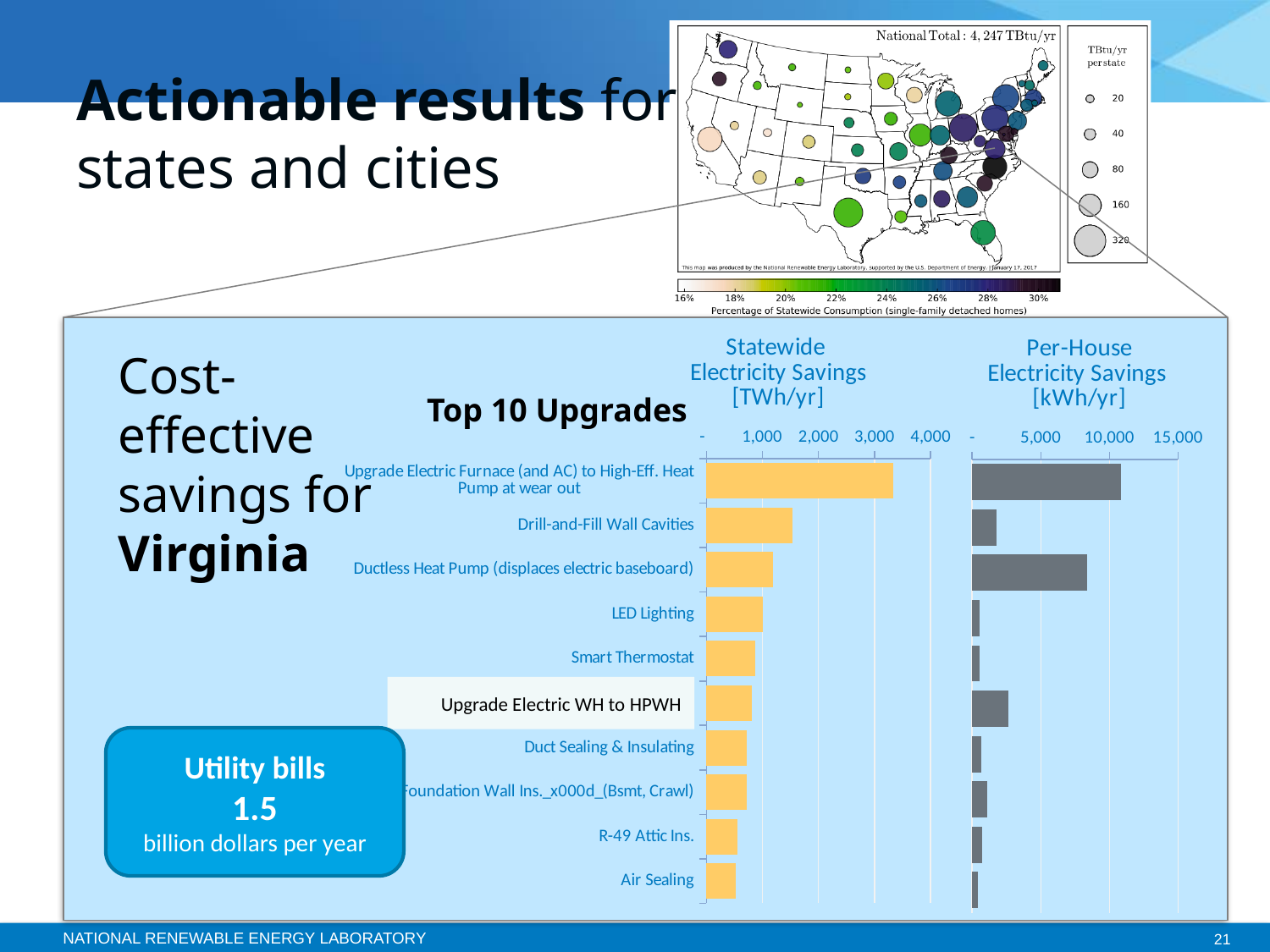
In the Statewide Electricity Savings chart, is the value for Drill-and-Fill Wall Cavities greater or less than 1,000? greater In the Statewide Electricity Savings chart, which is larger: Drill-and-Fill Wall Cavities or LED Lighting? Drill-and-Fill Wall Cavities In the Statewide Electricity Savings chart, is the value for Air Sealing greater or less than 1,000? less In the Per-House Electricity Savings chart, is the value for Ductless Heat Pump (displaces electric baseboard) greater or less than 5,000? greater How many upgrades are listed in the Top 10 Upgrades charts? 10 What kind of chart is the Statewide Electricity Savings chart? bar chart What unit is used on the Per-House Electricity Savings chart? kWh/yr In the Per-House Electricity Savings chart, which is larger: Ductless Heat Pump (displaces electric baseboard) or Upgrade Electric WH to HPWH? Ductless Heat Pump (displaces electric baseboard) In the Statewide Electricity Savings chart, which upgrade has the highest value? Upgrade Electric Furnace (and AC) to High-Eff. Heat Pump at wear out